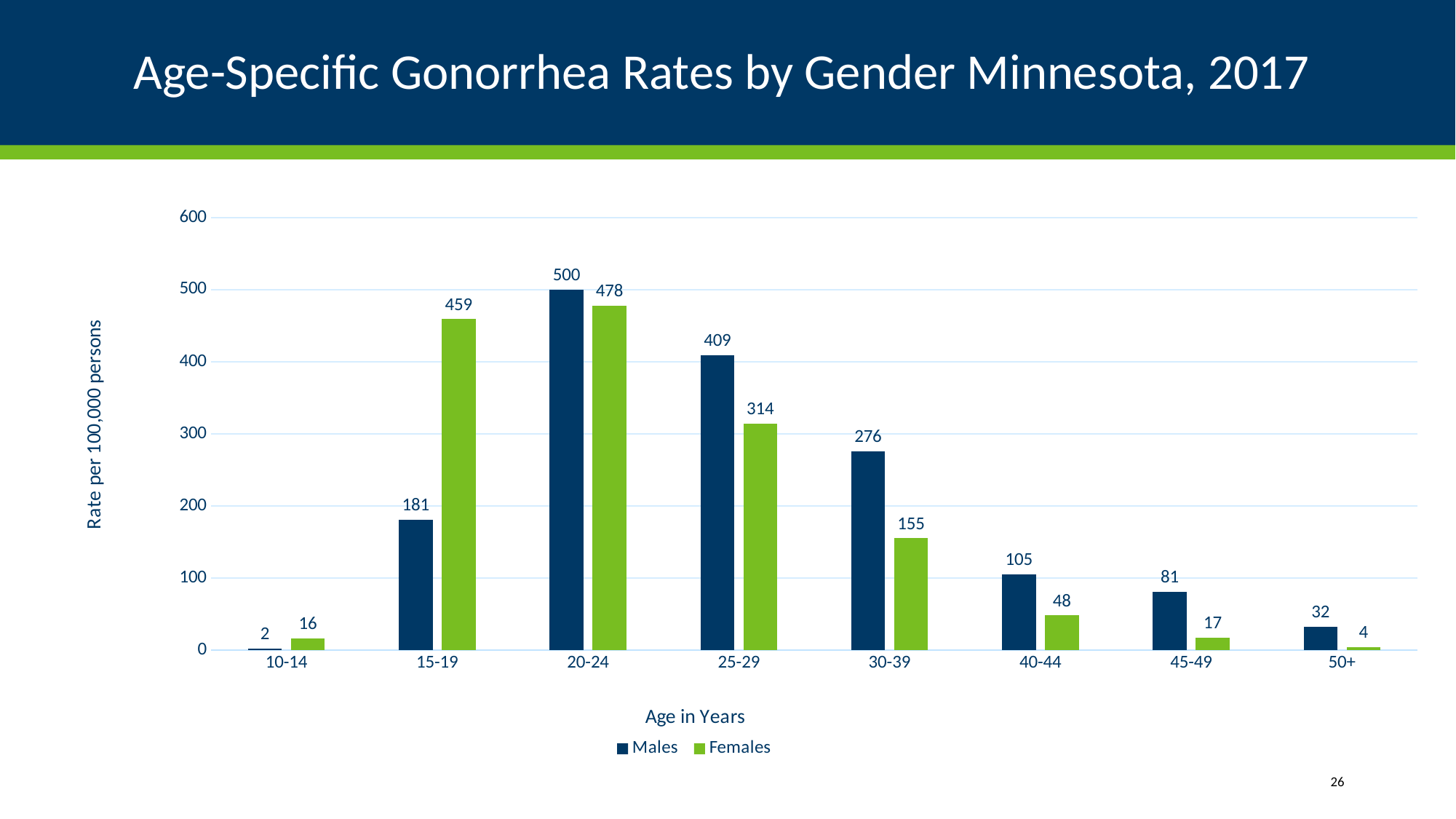
What is the gonorrhea rate for females aged 15-19? 459 What is the difference between the male and female rates for the 25-29 age group? 95 Which age group has the highest rate for males? 20-24 Is the value for males aged 30-39 greater or less than 200? greater Which is larger for the 15-19 age group, the male rate or the female rate? Females How many series does the legend list? 2 What is the label of the y axis? Rate per 100,000 persons What is the gonorrhea rate for males aged 20-24? 500 What is the gonorrhea rate for females aged 40-44? 48 Which age group has the lowest rate for females? 50+ How many age groups are shown on the x axis? 8 What kind of chart is shown on the slide? Bar chart